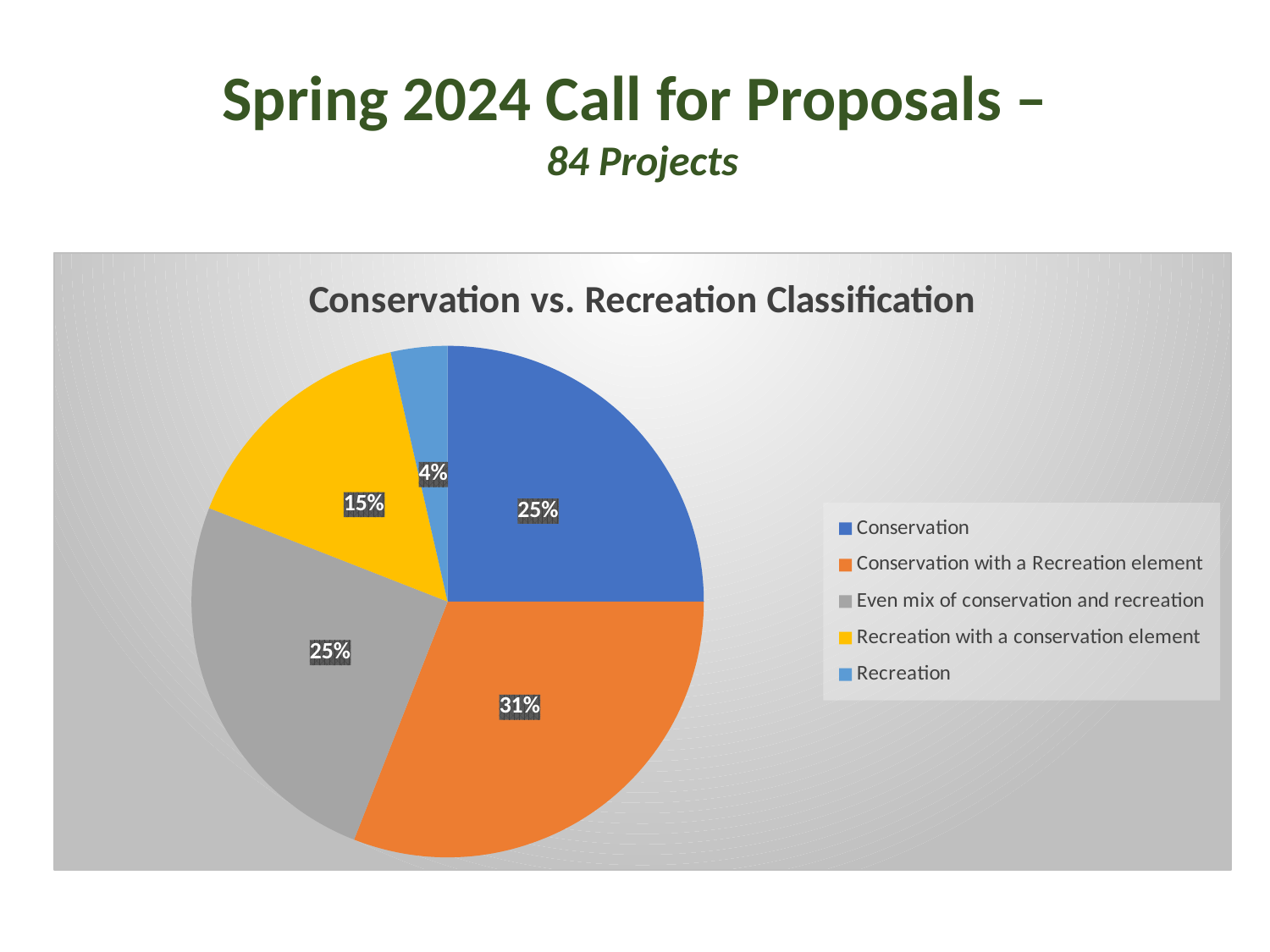
Which category has the smallest slice of the pie? Recreation What share of the pie is Recreation with a conservation element? 15% Which category has the largest slice of the pie? Conservation with a Recreation element What share of the pie is Conservation? 25% What is the difference in percentage points between Conservation with a Recreation element and Recreation with a conservation element? 16 Which is larger, the slice for Recreation with a conservation element or the slice for Recreation? Recreation with a conservation element What share of the pie is Conservation with a Recreation element? 31% What colour is the slice for Even mix of conservation and recreation? grey What is the chart's title? Conservation vs. Recreation Classification How many categories does the legend list? 5 What kind of chart is shown on the slide? pie chart